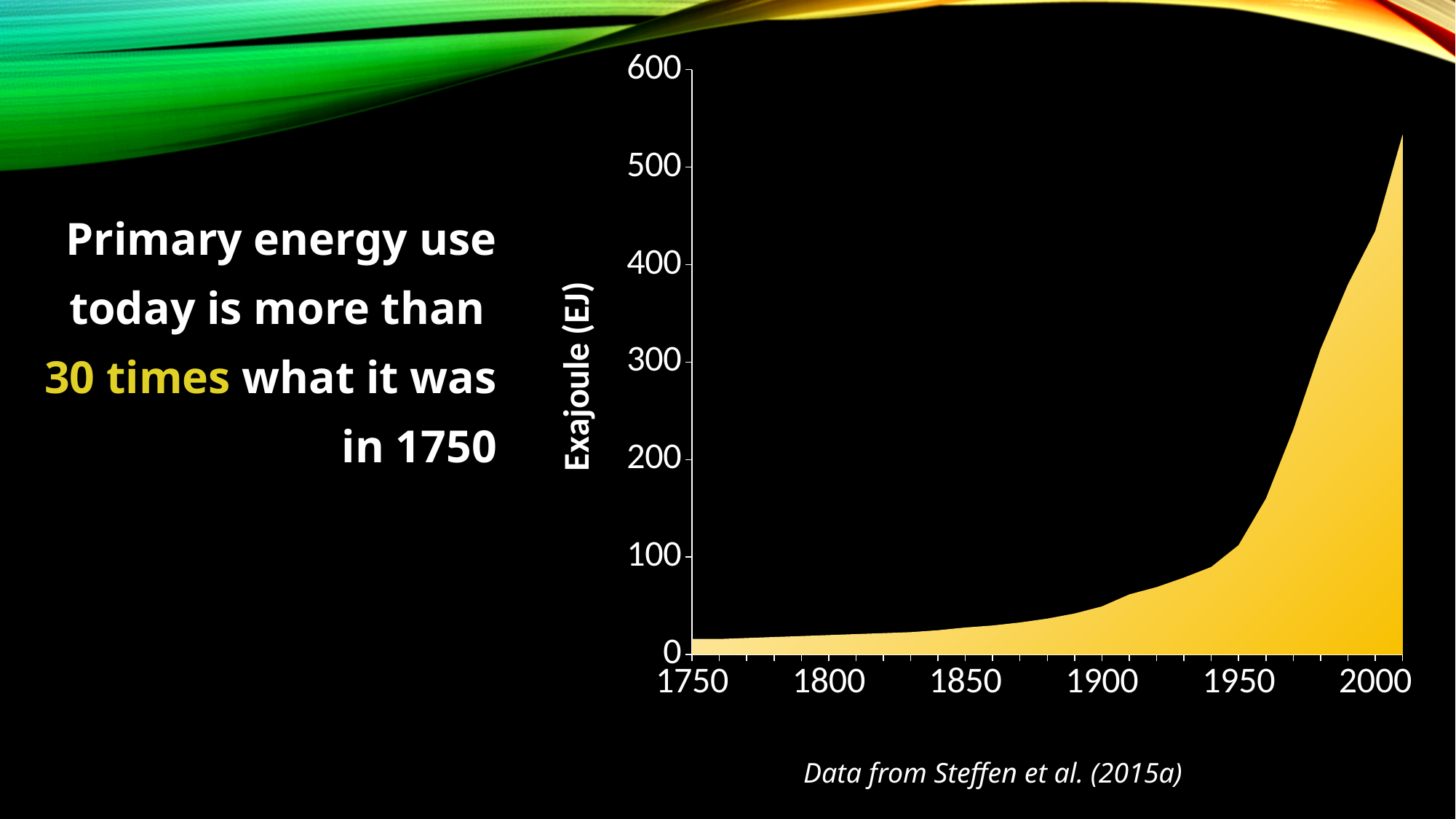
What kind of chart is shown on the slide? Area chart What is the highest value shown on the y axis? 600 Is the value at the right-hand end of the chart greater or less than 400? greater Which year label on the x axis corresponds to the lowest plotted value? 1750 Is the value for 2000 greater or less than 300? greater Is the value for 1850 greater or less than 100? less Do the values in the chart rise or fall from 1750 to 2000? Rise How many year labels are shown on the x axis? 6 What is the label on the y axis of the chart? Exajoule (EJ)